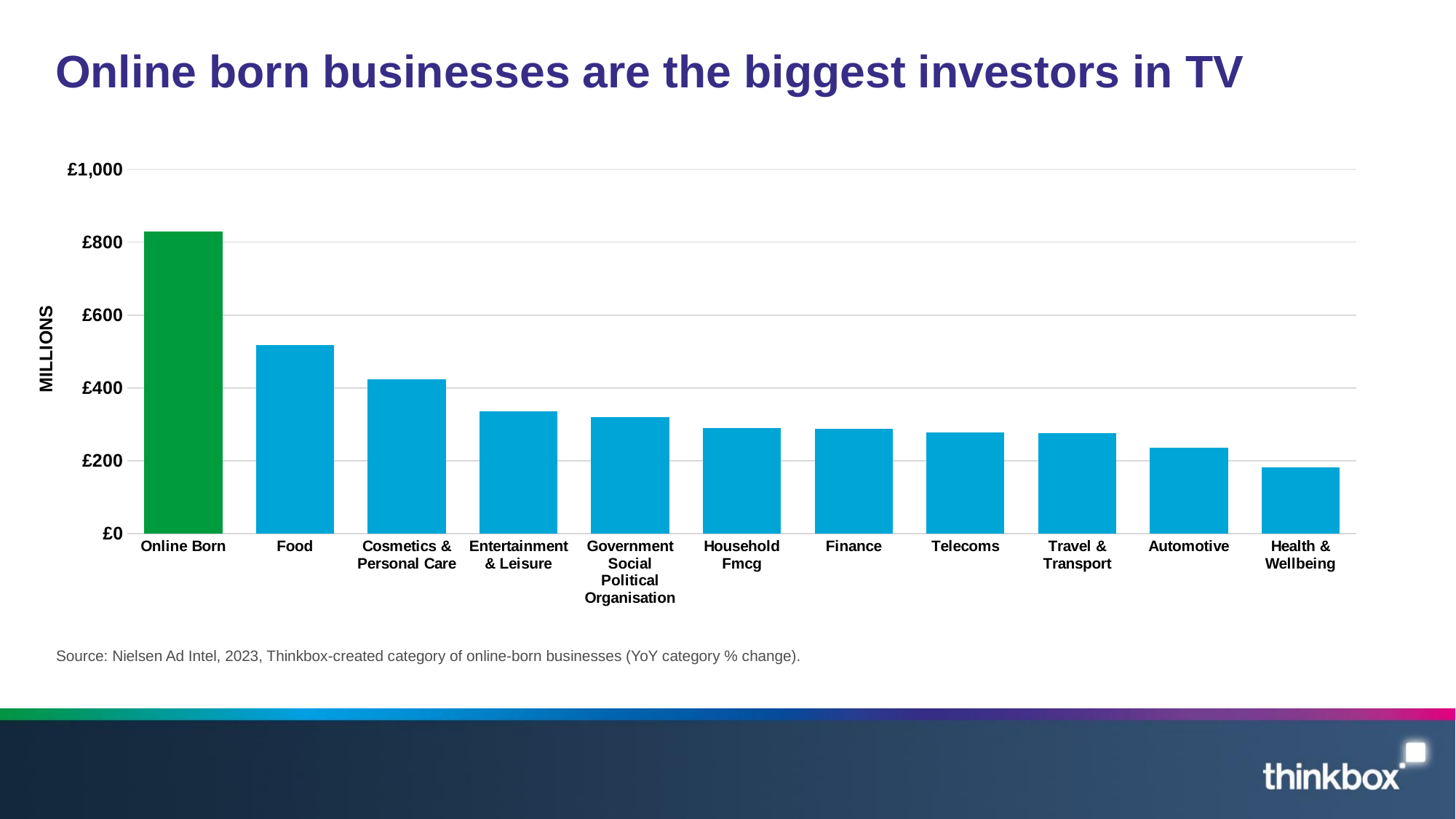
Which is larger, the value for Food or the value for Cosmetics & Personal Care? Food Is the value for Health & Wellbeing greater or less than £200? less Is the value for Entertainment & Leisure greater or less than £400? less Is the value for Cosmetics & Personal Care greater or less than £400? greater How many categories are shown on the x axis of the chart? 11 Which category has the lowest value in the chart? Health & Wellbeing Do the values rise or fall moving from left to right along the x axis? Fall Which category has the highest value in the chart? Online Born What kind of chart is shown on the slide? Bar chart Which bar in the chart is coloured green rather than blue? Online Born